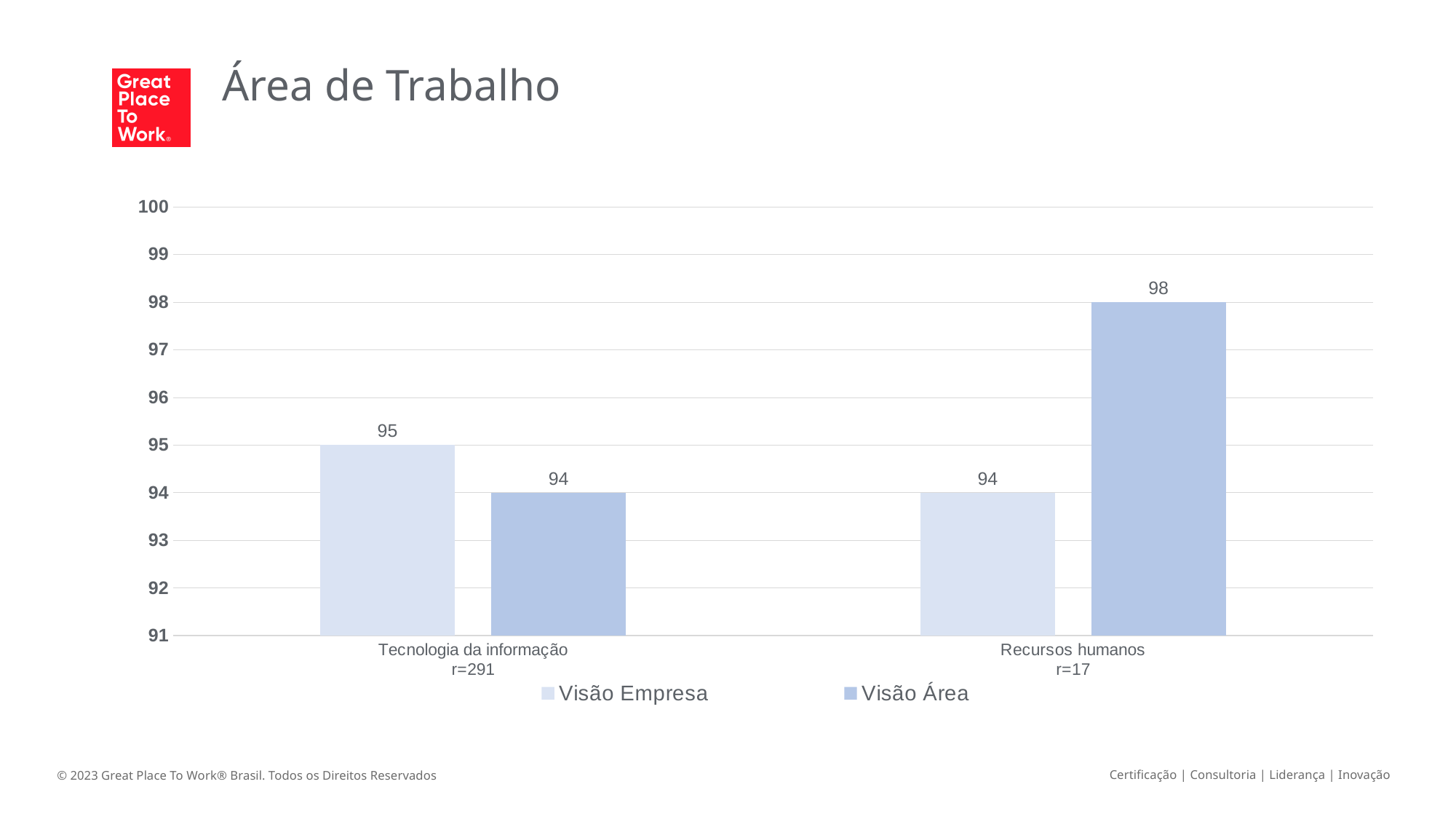
How many categories are shown on the x axis? 2 What is the title of the slide? Área de Trabalho What is the Visão Empresa value for Recursos humanos? 94 How many series does the legend list? 2 What is the difference between the Visão Área and Visão Empresa values for Recursos humanos? 4 For Tecnologia da informação, which is larger: Visão Empresa or Visão Área? Visão Empresa What is the Visão Empresa value for Tecnologia da informação? 95 What kind of chart is shown on the slide? Bar chart What is the Visão Área value for Recursos humanos? 98 What is the Visão Área value for Tecnologia da informação? 94 Which category has the lowest Visão Empresa value? Recursos humanos Which category has the highest Visão Área value? Recursos humanos